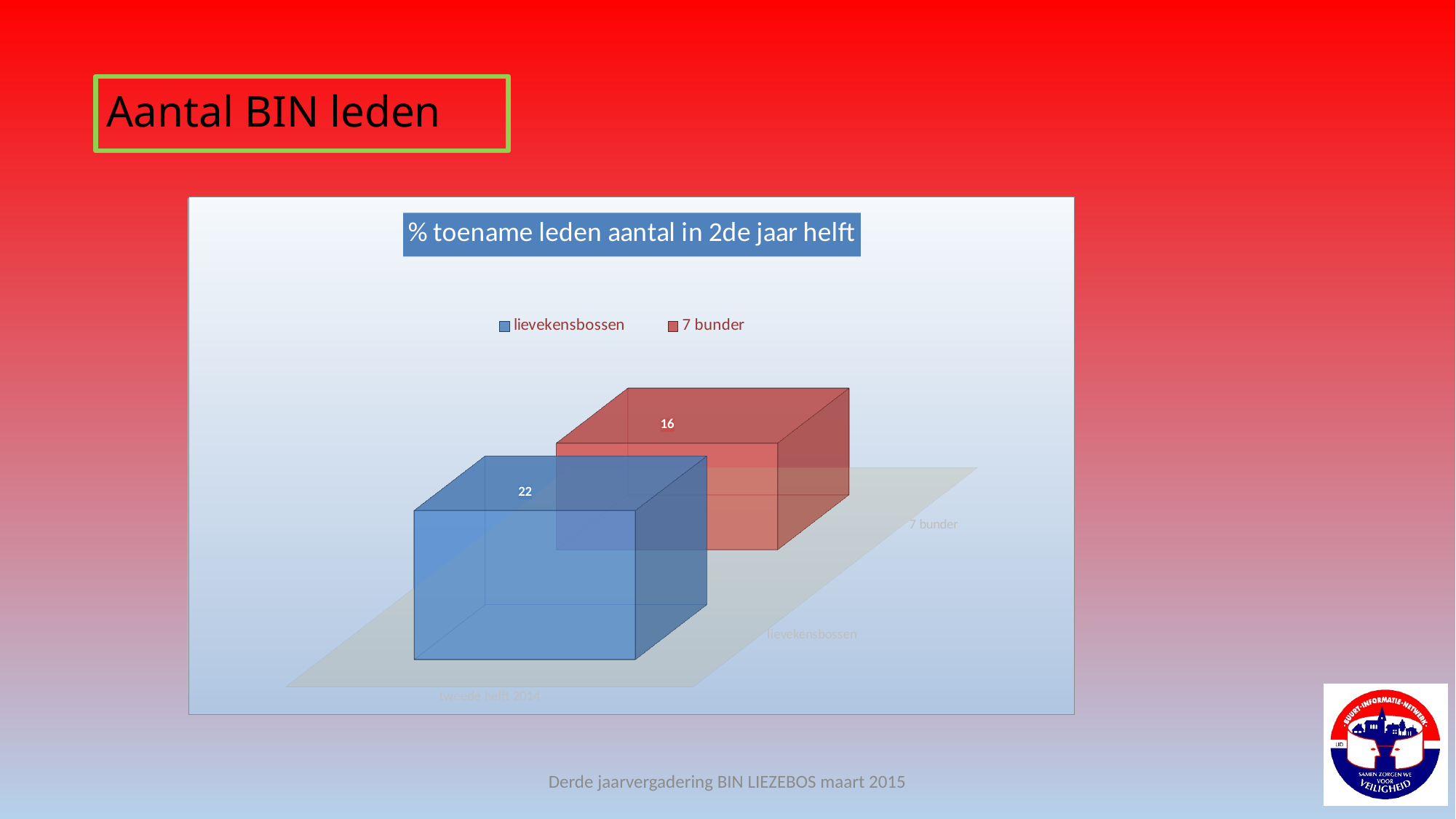
What is the value for 7 bunder? 16 How many series does the legend list? 2 Which series has the lowest value? 7 bunder What is the value for lievekensbossen? 22 What colour is the bar for 7 bunder? Red What is the category label shown on the x axis? tweede helft 2014 What is the difference between the values for lievekensbossen and 7 bunder? 6 What kind of chart is shown? 3D bar chart What is the title of the chart? % toename leden aantal in 2de jaar helft Which series has the higher value, lievekensbossen or 7 bunder? lievekensbossen